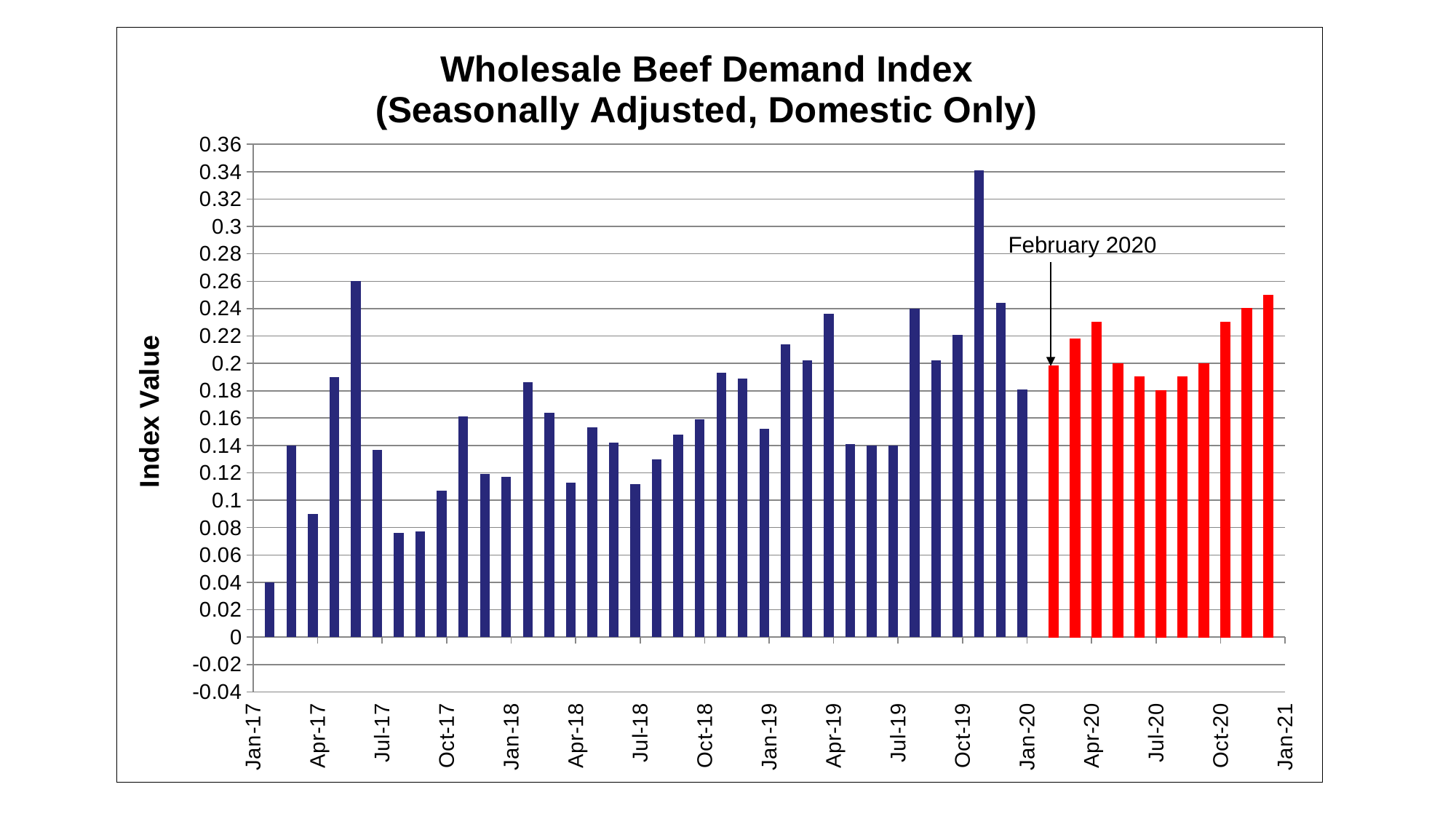
Is the value for Jul-19 greater or less than 0.22? less Is the highest bar on the chart greater or less than 0.32? greater What month does the arrow annotation on the chart point to? February 2020 Is the value for Apr-20 greater or less than 0.2? greater Which is larger, the value for Apr-17 or the value for Jan-17? Apr-17 What is the title of the y-axis? Index Value What kind of chart is shown on the slide? Bar chart